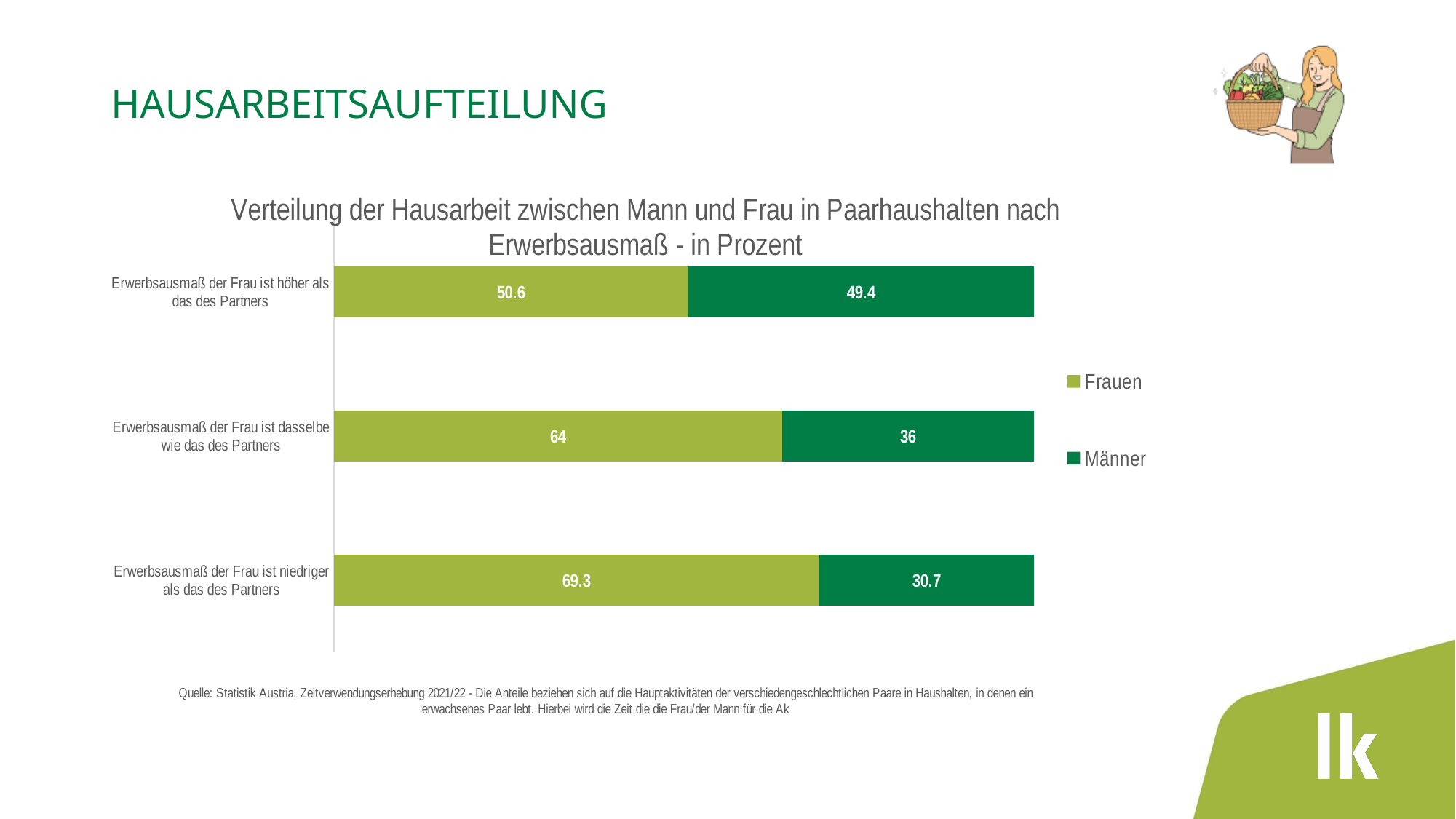
How many series does the legend list? 2 What is the Männer value for 'Erwerbsausmaß der Frau ist höher als das des Partners'? 49.4 What is the difference between the Frauen and Männer values for 'Erwerbsausmaß der Frau ist niedriger als das des Partners'? 38.6 In which category is the Männer share lowest? Erwerbsausmaß der Frau ist niedriger als das des Partners What is the Frauen value for 'Erwerbsausmaß der Frau ist niedriger als das des Partners'? 69.3 What is the Männer value for 'Erwerbsausmaß der Frau ist dasselbe wie das des Partners'? 36 What is the Frauen value for 'Erwerbsausmaß der Frau ist höher als das des Partners'? 50.6 Which is larger for 'Erwerbsausmaß der Frau ist dasselbe wie das des Partners': the Frauen value or the Männer value? Frauen In which category is the Frauen share highest? Erwerbsausmaß der Frau ist niedriger als das des Partners What is the total of the stacked bar for 'Erwerbsausmaß der Frau ist dasselbe wie das des Partners'? 100 How many categories are shown in the chart? 3 What kind of chart is shown on the slide? Stacked bar chart